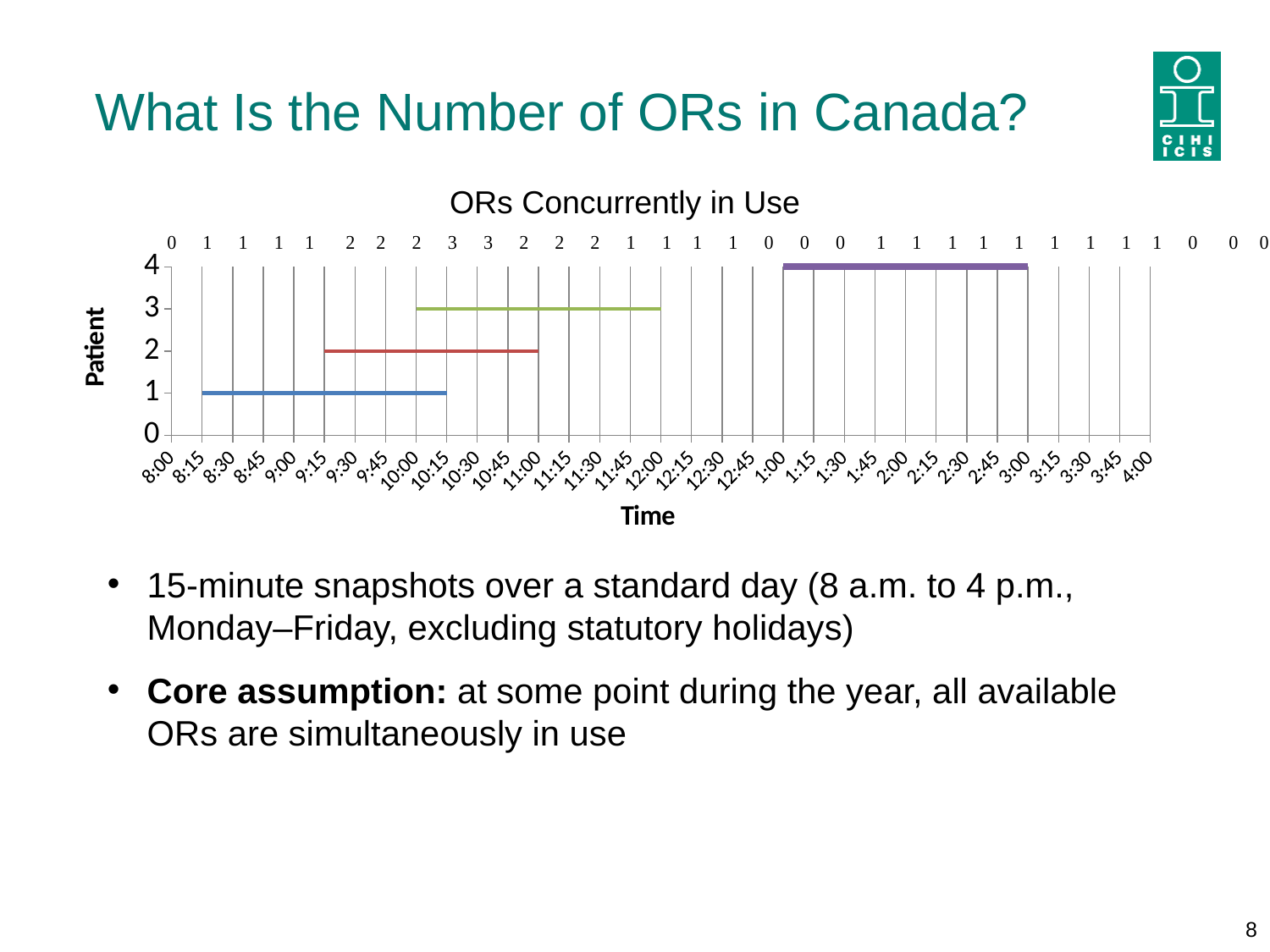
According to the data labels above the chart, how many ORs are concurrently in use at 10:00? 3 Is the number of ORs concurrently in use at 10:15 greater or less than 2? greater What is the title of the chart? ORs Concurrently in Use How many patient lines are plotted on the chart? 4 What is the label of the vertical axis of the chart? Patient According to the data labels above the chart, how many ORs are concurrently in use at 9:15? 2 What is the highest number of ORs concurrently in use shown in the data labels above the chart? 3 What is the highest value shown on the vertical axis of the chart? 4 According to the data labels above the chart, how many ORs are concurrently in use at 8:00? 0 At what time does the line for Patient 1 begin? 8:15 At what time does the line for Patient 4 end? 3:00 Which patient's line starts later, Patient 3 or Patient 4? Patient 4